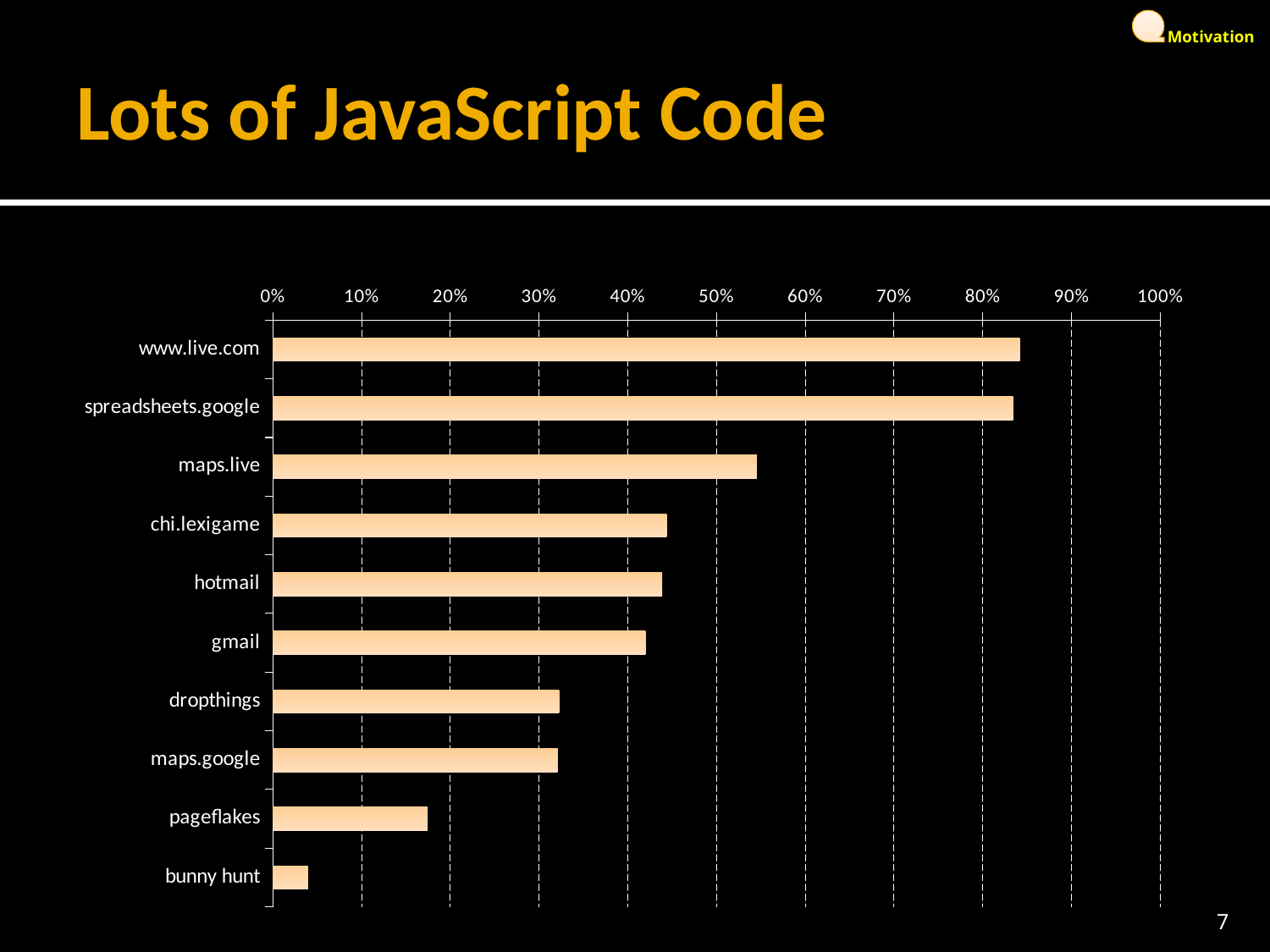
Is the value for dropthings greater or less than 30%? greater Is the value for maps.live greater or less than 50%? greater How many categories (websites) are plotted in the chart? 10 What is the title of the slide containing the chart? Lots of JavaScript Code Is the value for hotmail greater or less than 50%? less Which has the larger value, gmail or dropthings? gmail Which has the larger value, maps.live or chi.lexigame? maps.live Which category has the lowest value in the chart? bunny hunt What kind of chart is shown on the slide? bar chart